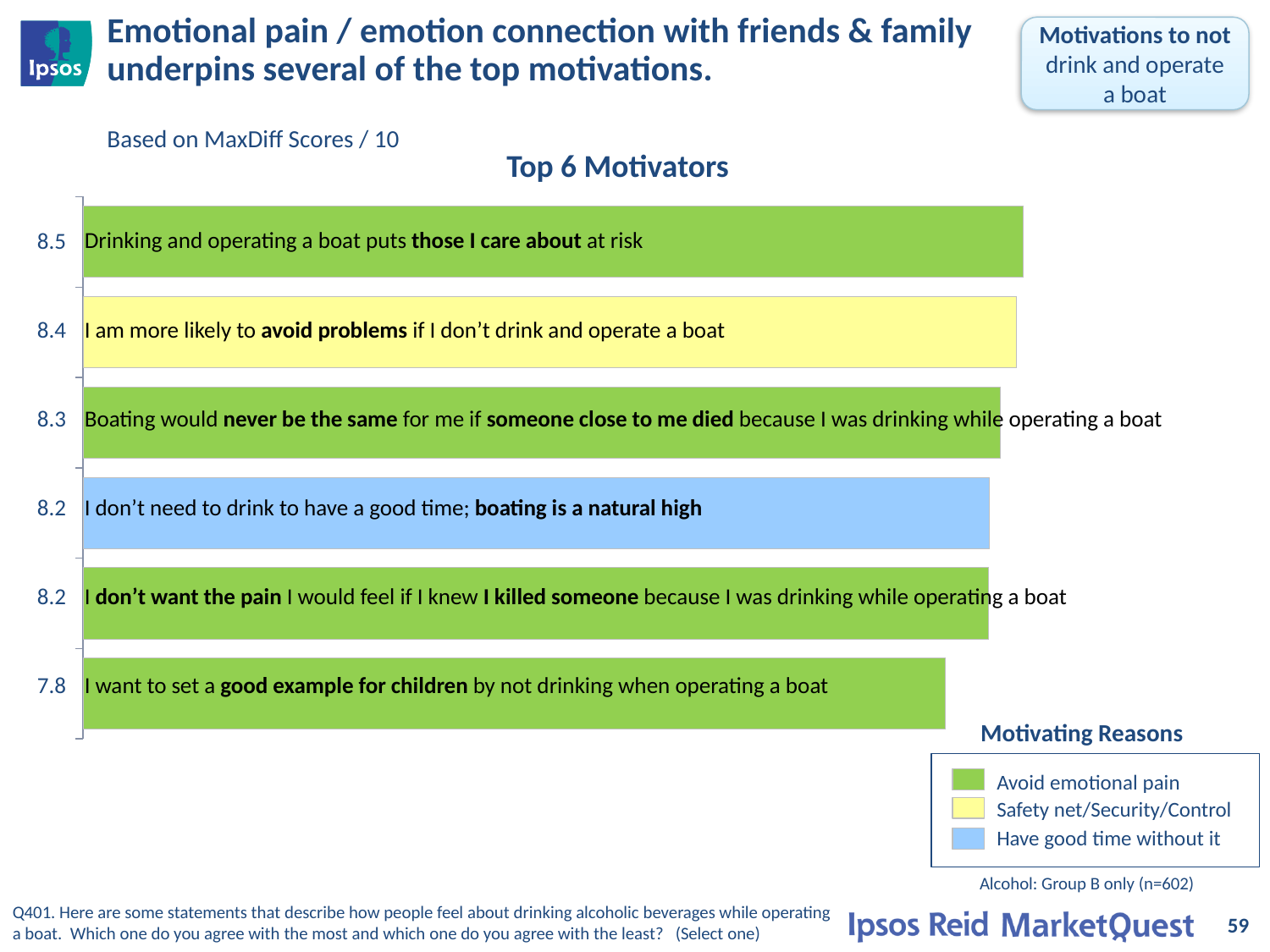
How many motivators are shown in the Top 6 Motivators chart? 6 How many motivating reason categories does the legend list? 3 Which motivator has the lowest MaxDiff score? I want to set a good example for children by not drinking when operating a boat What is the difference between the highest score (8.5) and the lowest score (7.8) in the Top 6 Motivators chart? 0.7 What is the MaxDiff score for "I am more likely to avoid problems if I don't drink and operate a boat"? 8.4 How many of the six motivators are in the "Avoid emotional pain" category? 4 Which motivator has the highest MaxDiff score? Drinking and operating a boat puts those I care about at risk What is the MaxDiff score for "Drinking and operating a boat puts those I care about at risk"? 8.5 Which motivating reason category does the yellow bar represent? Safety net/Security/Control Which has a higher score: "I am more likely to avoid problems if I don't drink and operate a boat" or "I don't need to drink to have a good time; boating is a natural high"? I am more likely to avoid problems if I don't drink and operate a boat What is the MaxDiff score for "I want to set a good example for children by not drinking when operating a boat"? 7.8 What type of chart is the Top 6 Motivators chart? Bar chart